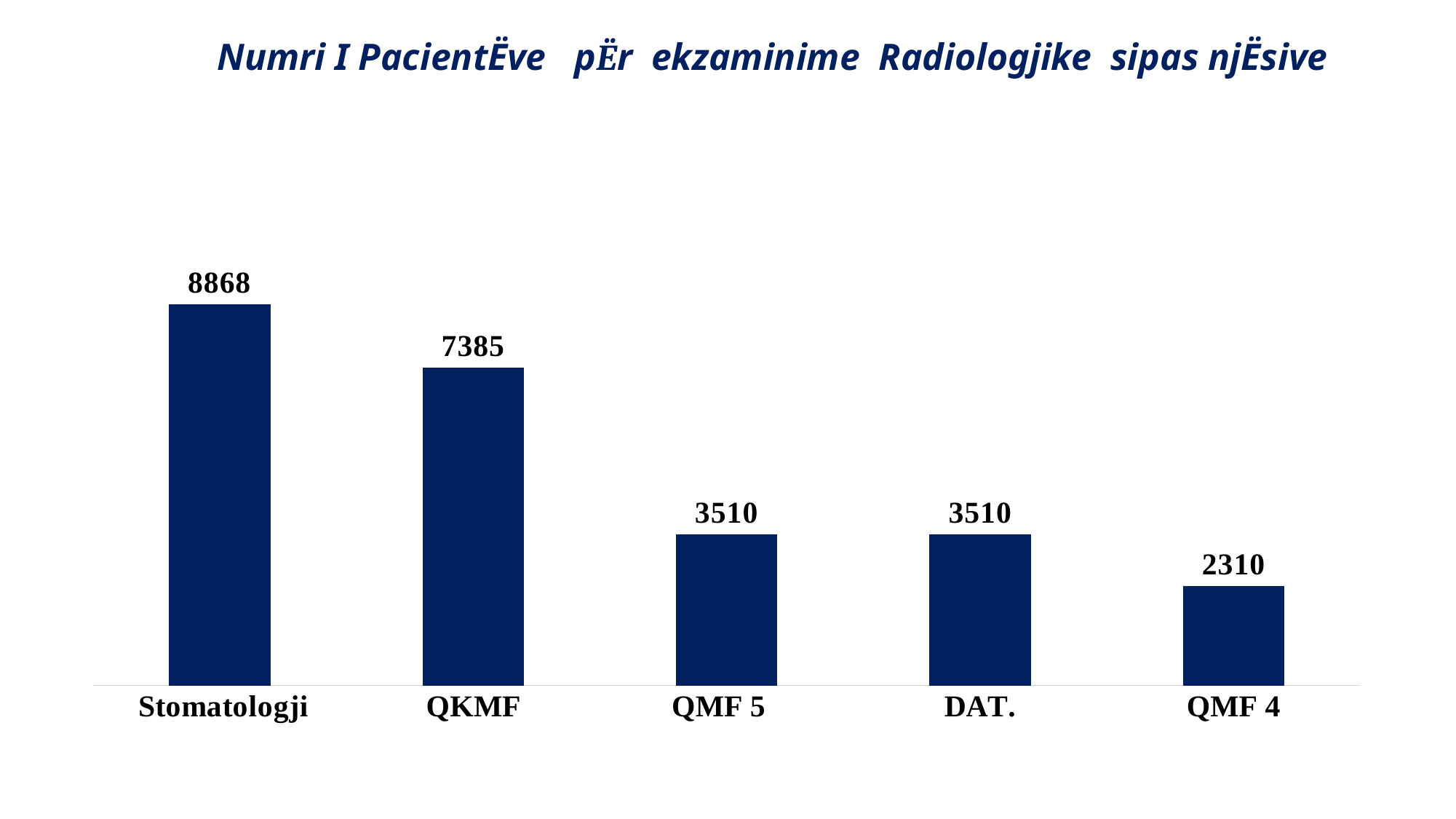
What is the difference between the values for QMF 5 and QMF 4? 1200 Which is larger, the value for QKMF or the value for QMF 5? QKMF Which category has the lowest value? QMF 4 Do the values rise or fall from left to right across the categories? Fall Which category has the highest value? Stomatologji What kind of chart is shown on the slide? Bar chart What is the value for QKMF? 7385 What is the value for Stomatologji? 8868 What is the value for QMF 4? 2310 What is the difference between the values for Stomatologji and QKMF? 1483 How many categories are shown in the chart? 5 What is the value for DAT.? 3510